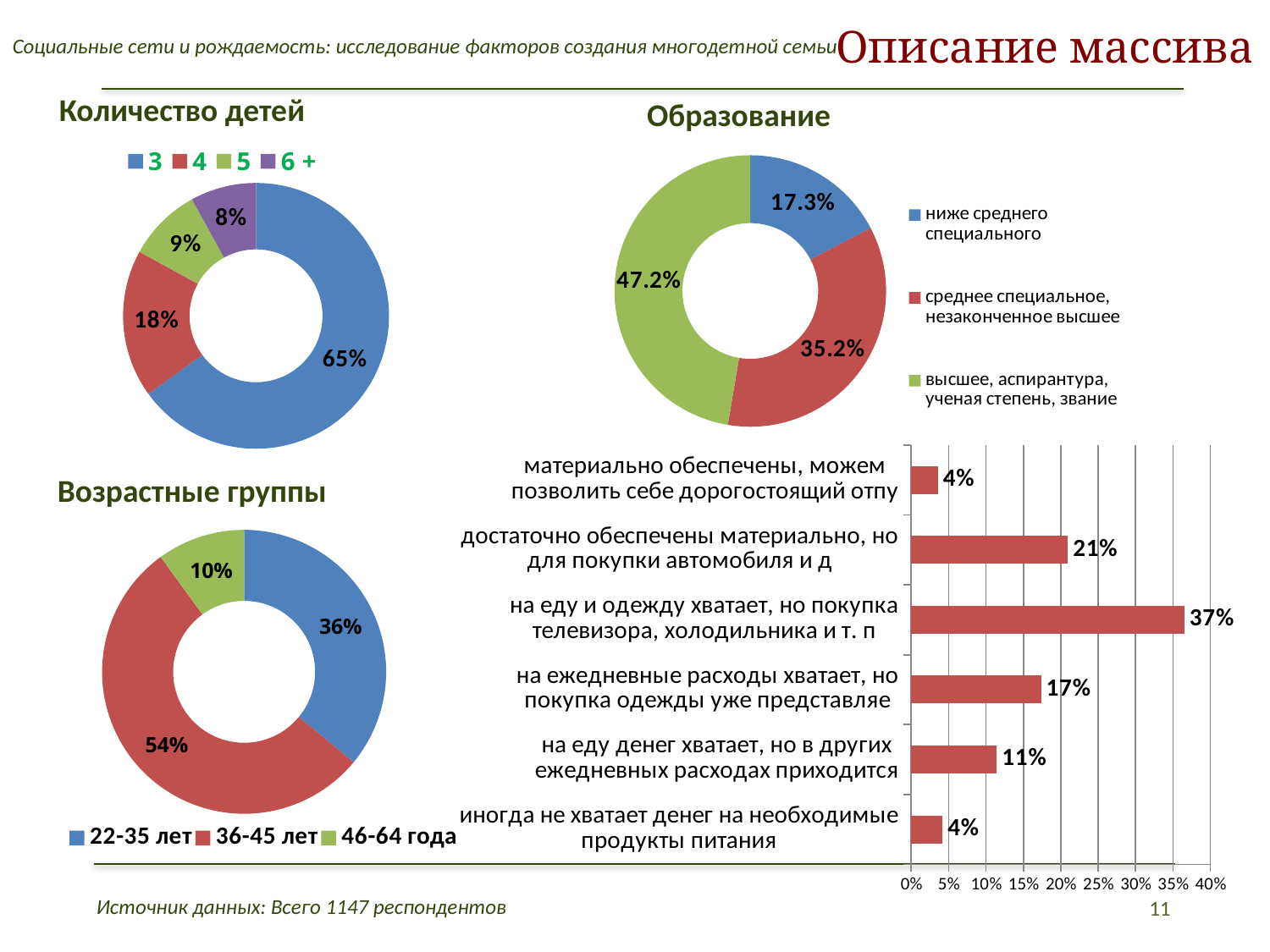
In the bar chart at the bottom right, what is the difference between the values for "достаточно обеспечены материально, но для покупки автомобиля и д" and "на еду денег хватает, но в других ежедневных расходах приходится"? 10% In the "Образование" chart, what is the share for "среднее специальное, незаконченное высшее"? 35.2% What kind of chart is the "Возрастные группы" chart? Doughnut chart In the "Количество детей" chart, what share of respondents have 3 children? 65% In the bar chart at the bottom right, how many categories are plotted? 6 In the "Возрастные группы" chart, which is larger: the share for "22-35 лет" or for "46-64 года"? 22-35 лет In the bar chart at the bottom right, what is the value for "на еду и одежду хватает, но покупка телевизора, холодильника и т. п"? 37% In the "Образование" chart, which category has the largest share? высшее, аспирантура, ученая степень, звание In the "Образование" chart, what is the difference between the shares for "высшее, аспирантура, ученая степень, звание" and "ниже среднего специального"? 29.9% In the "Количество детей" chart, which category has the smallest share? 6 + In the "Возрастные группы" chart, what is the share for "36-45 лет"? 54% How many categories does the legend of the "Количество детей" chart list? 4